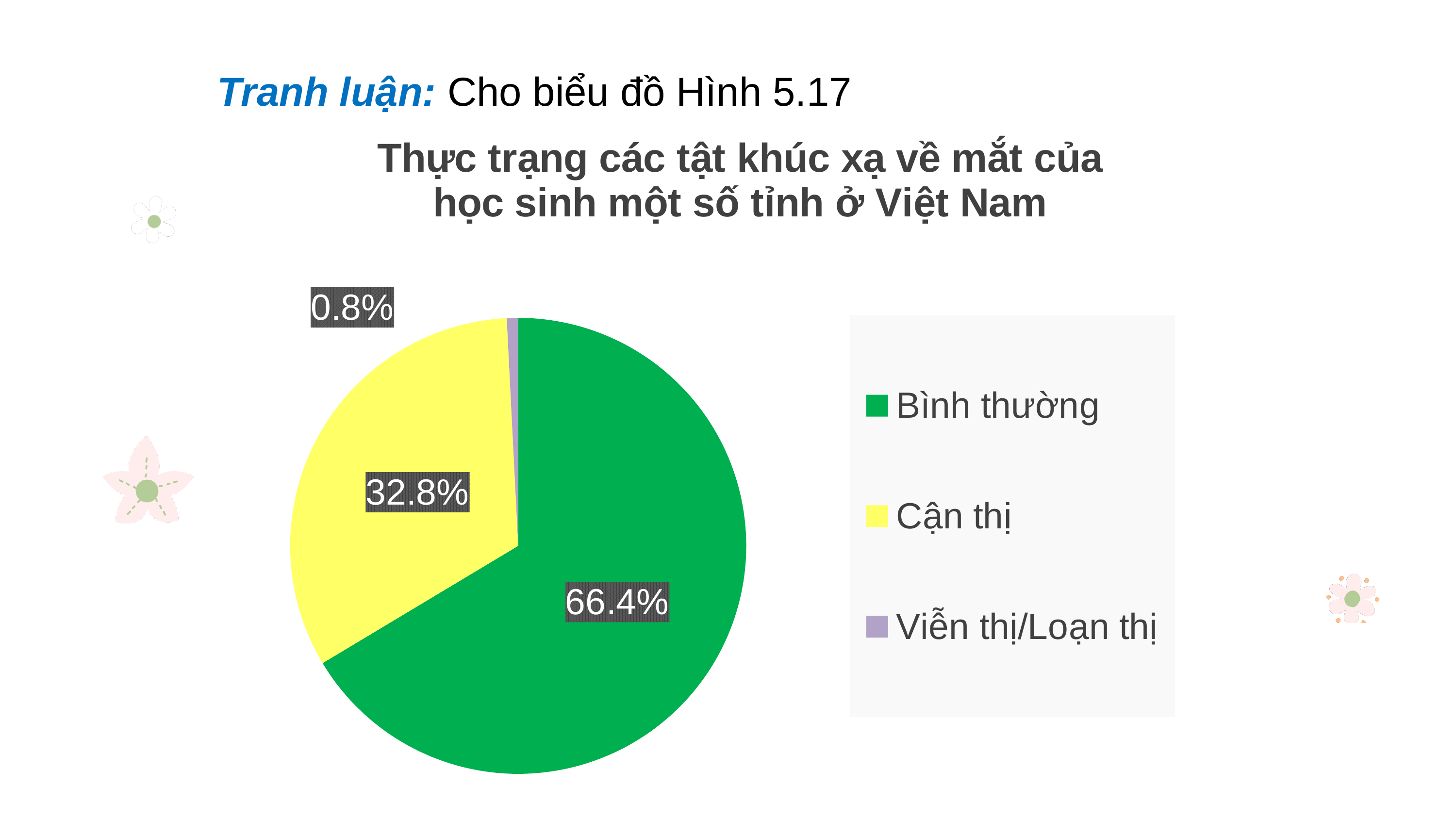
How many categories does the pie chart show? 3 What percentage of the pie chart is labelled for Viễn thị/Loạn thị? 0.8% What percentage of the pie chart is labelled for Bình thường? 66.4% What kind of chart is shown on the slide? Pie chart What is the difference in percentage points between Bình thường and Cận thị? 33.6 What is the combined share of Cận thị and Viễn thị/Loạn thị? 33.6% What colour is the slice for Cận thị? Yellow Which is larger, the share for Cận thị or the share for Viễn thị/Loạn thị? Cận thị Which category has the smallest slice of the pie chart? Viễn thị/Loạn thị Which category has the largest slice of the pie chart? Bình thường What percentage of the pie chart is labelled for Cận thị? 32.8% What is the title of the chart? Thực trạng các tật khúc xạ về mắt của học sinh một số tỉnh ở Việt Nam